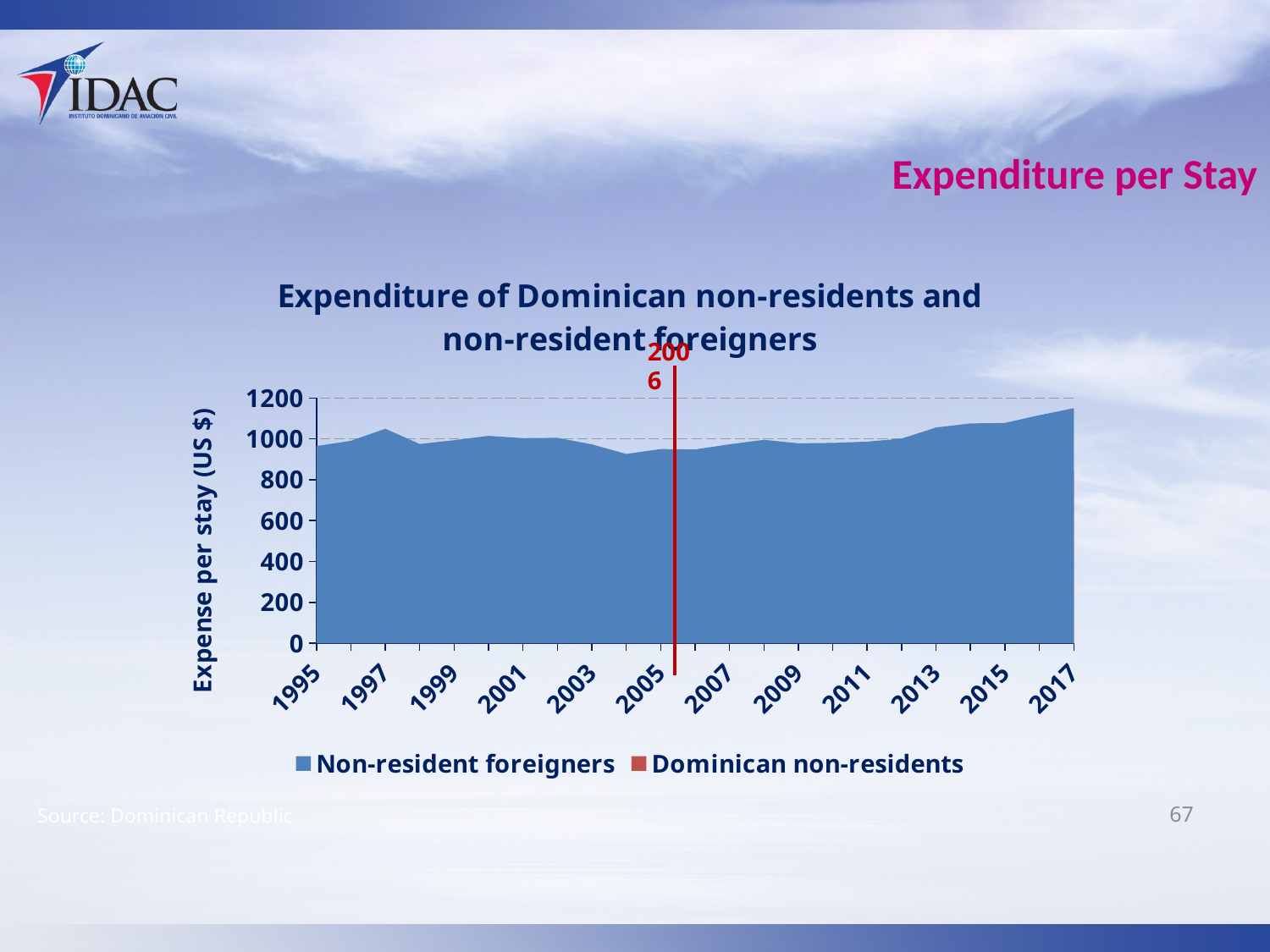
How many series does the legend list? 2 Does the Non-resident foreigners series rise or fall between 2013 and 2017? Rise Is the value for Non-resident foreigners in 2017 greater or less than 1200? less What is the title of the chart? Expenditure of Dominican non-residents and non-resident foreigners Is the value for Non-resident foreigners in 2005 greater or less than 1000? less Which is larger for Non-resident foreigners, the value in 2017 or the value in 2005? 2017 What kind of chart is shown on the slide? Area chart What is the label of the y axis? Expense per stay (US $) Is the value for Non-resident foreigners in 2009 greater or less than 800? greater In which year does the Non-resident foreigners series reach its highest value? 2017 What year is marked by the red vertical line on the chart? 2006